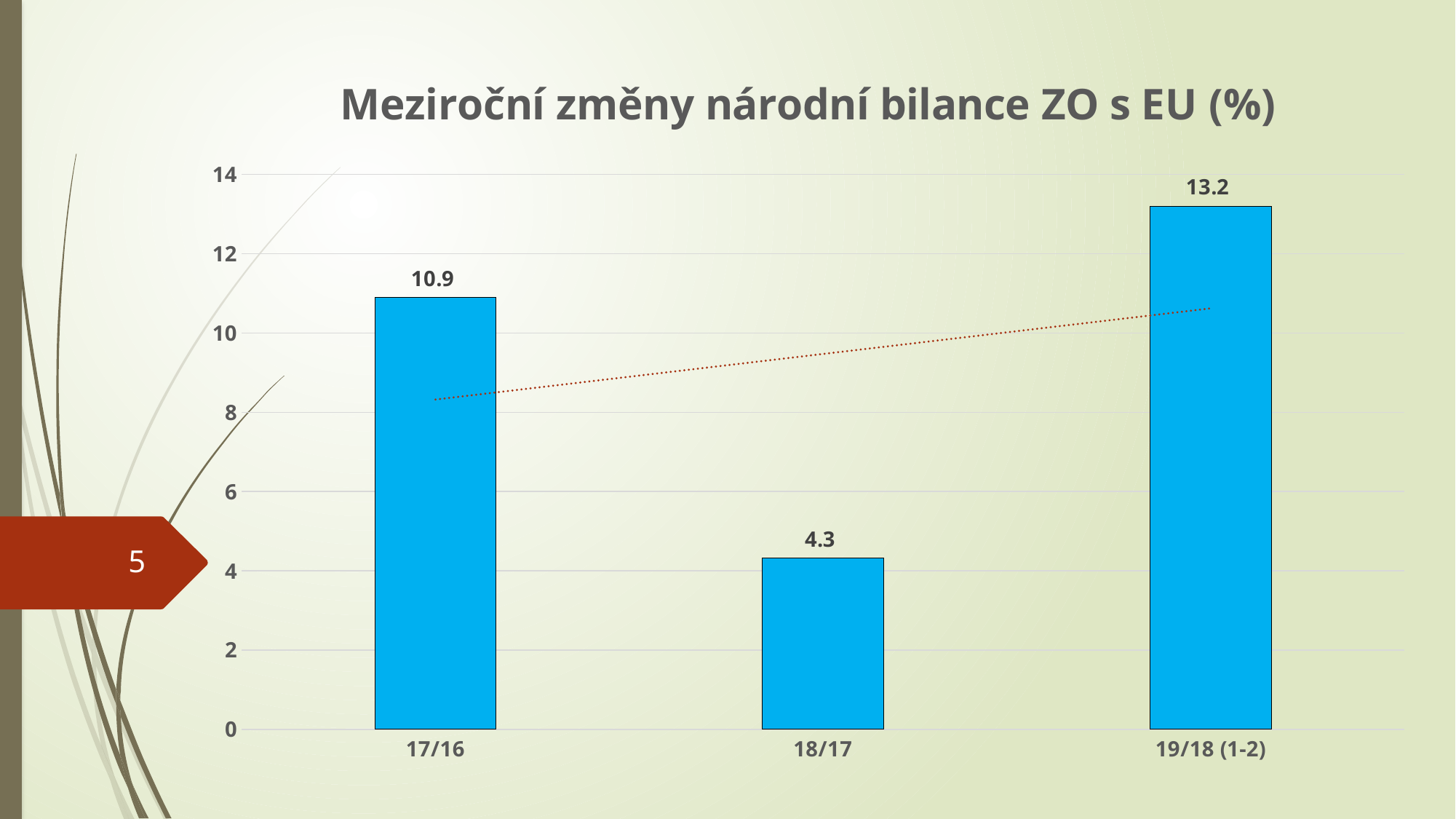
What is the value for 17/16? 10.9 What is the title of the chart? Meziroční změny národní bilance ZO s EU (%) Which is larger, the value for 17/16 or the value for 18/17? 17/16 Which category has the highest value? 19/18 (1-2) What is the value for 18/17? 4.3 What is the difference between the values for 17/16 and 18/17? 6.6 What kind of chart is shown on the slide? bar chart What is the difference between the values for 19/18 (1-2) and 17/16? 2.3 How many categories are shown on the x axis? 3 Is the value for 18/17 greater or less than 6? less What is the value for 19/18 (1-2)? 13.2 Which category has the lowest value? 18/17